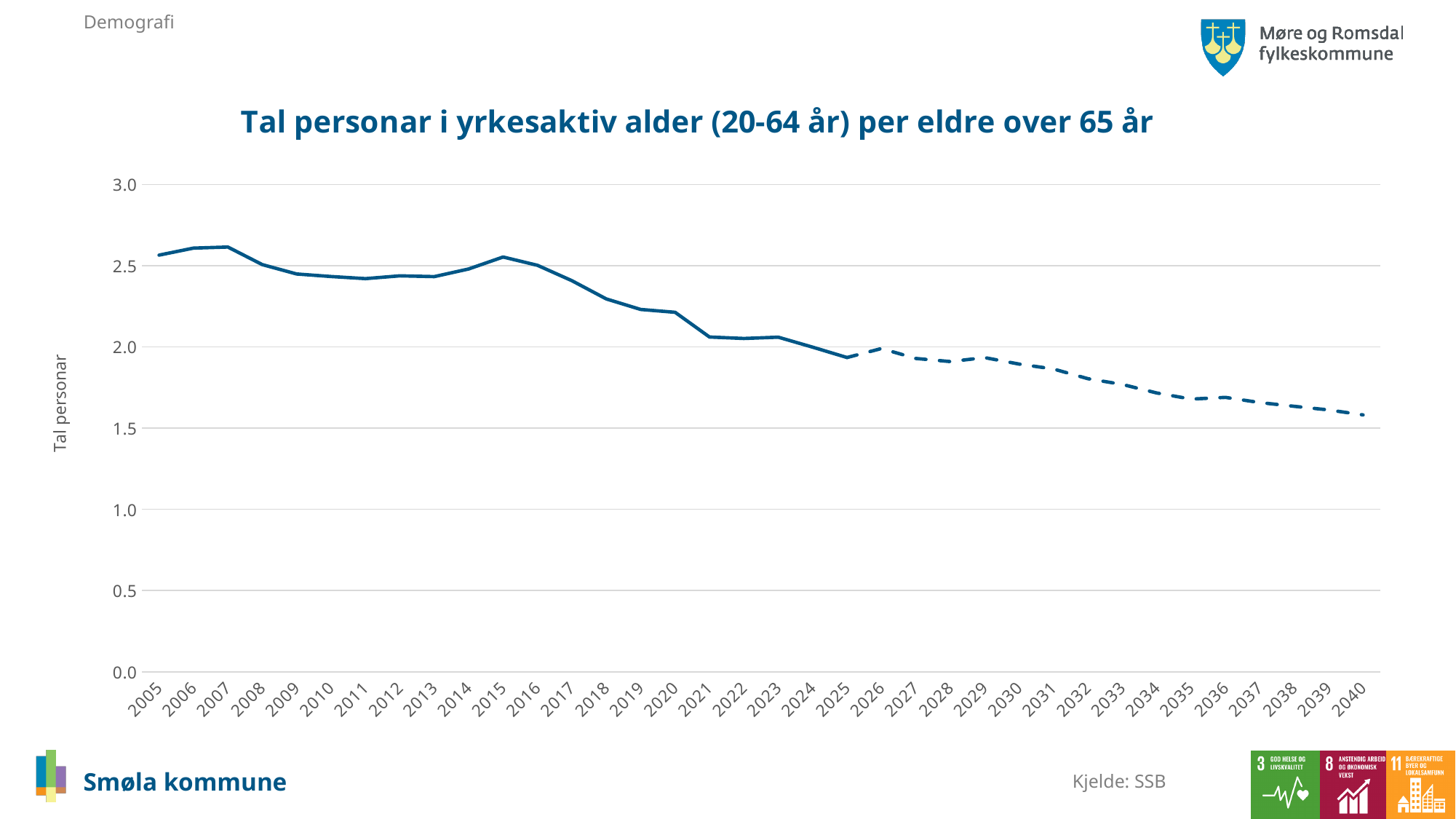
How many years are plotted along the x axis of the chart? 36 Overall, do the values rise or fall from 2005 to 2040? fall What kind of chart is shown on the slide? line chart What is the title of the chart? Tal personar i yrkesaktiv alder (20-64 år) per eldre over 65 år Which year has the larger value, 2015 or 2020? 2015 What is the label on the vertical axis of the chart? Tal personar Is the value for 2005 greater or less than 2.5? greater Which year has the lowest value on the chart? 2040 Which year has the larger value, 2005 or 2025? 2005 Is the value for 2035 greater or less than 2.0? less Is the value for 2021 greater or less than 2.0? greater